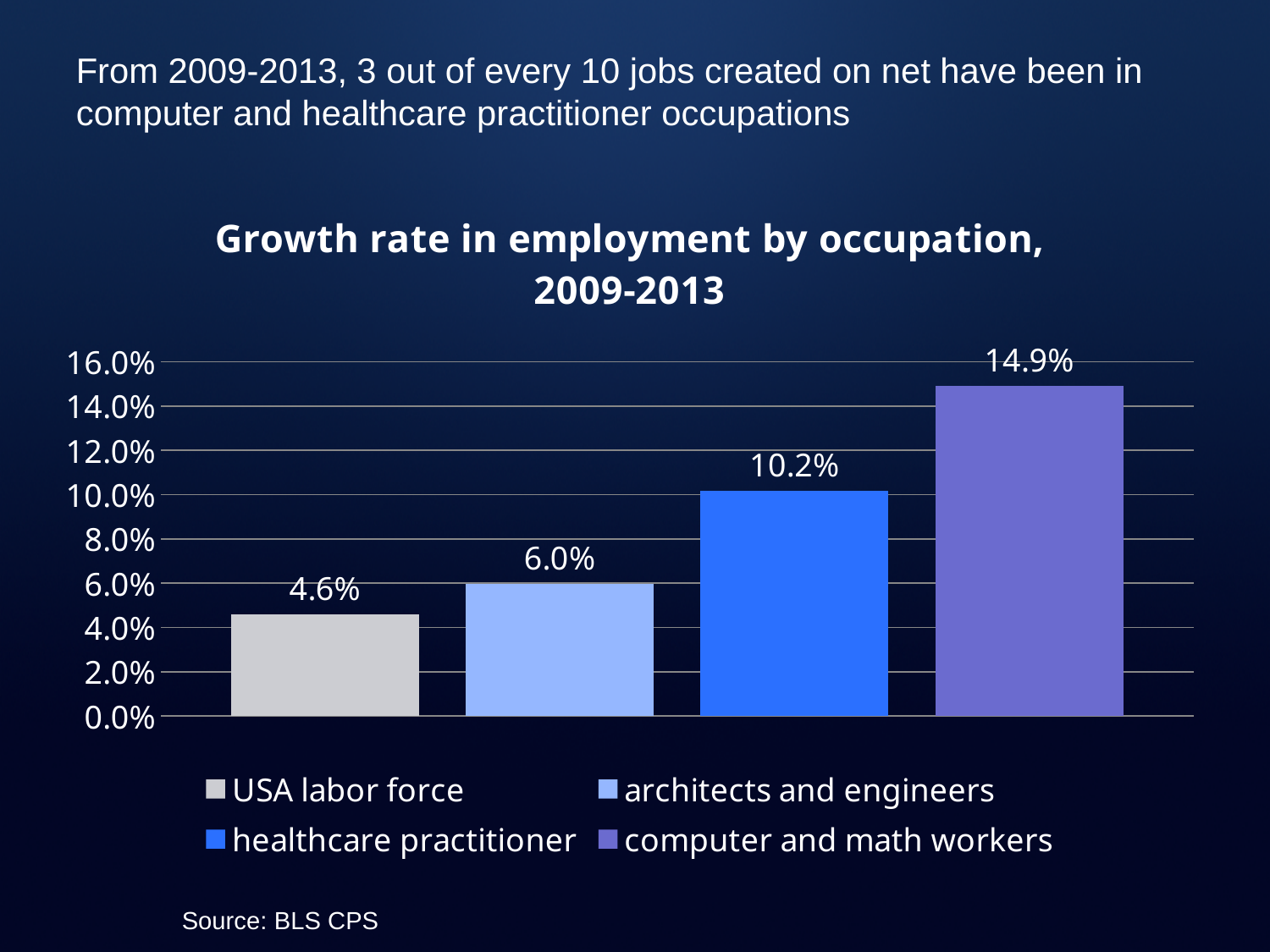
What is the difference in growth rate between computer and math workers and the USA labor force? 10.3% What is the title of the chart? Growth rate in employment by occupation, 2009-2013 How many series does the legend list? 4 What is the growth rate in employment for computer and math workers? 14.9% What is the growth rate in employment for architects and engineers? 6.0% Which occupation group has the highest growth rate in employment? computer and math workers What is the growth rate in employment for healthcare practitioners? 10.2% What kind of chart is shown on the slide? bar chart Which group has the lowest growth rate in employment? USA labor force Which has a higher growth rate: healthcare practitioner or architects and engineers? healthcare practitioner What is the difference in growth rate between healthcare practitioners and architects and engineers? 4.2% What is the growth rate in employment for the USA labor force? 4.6%